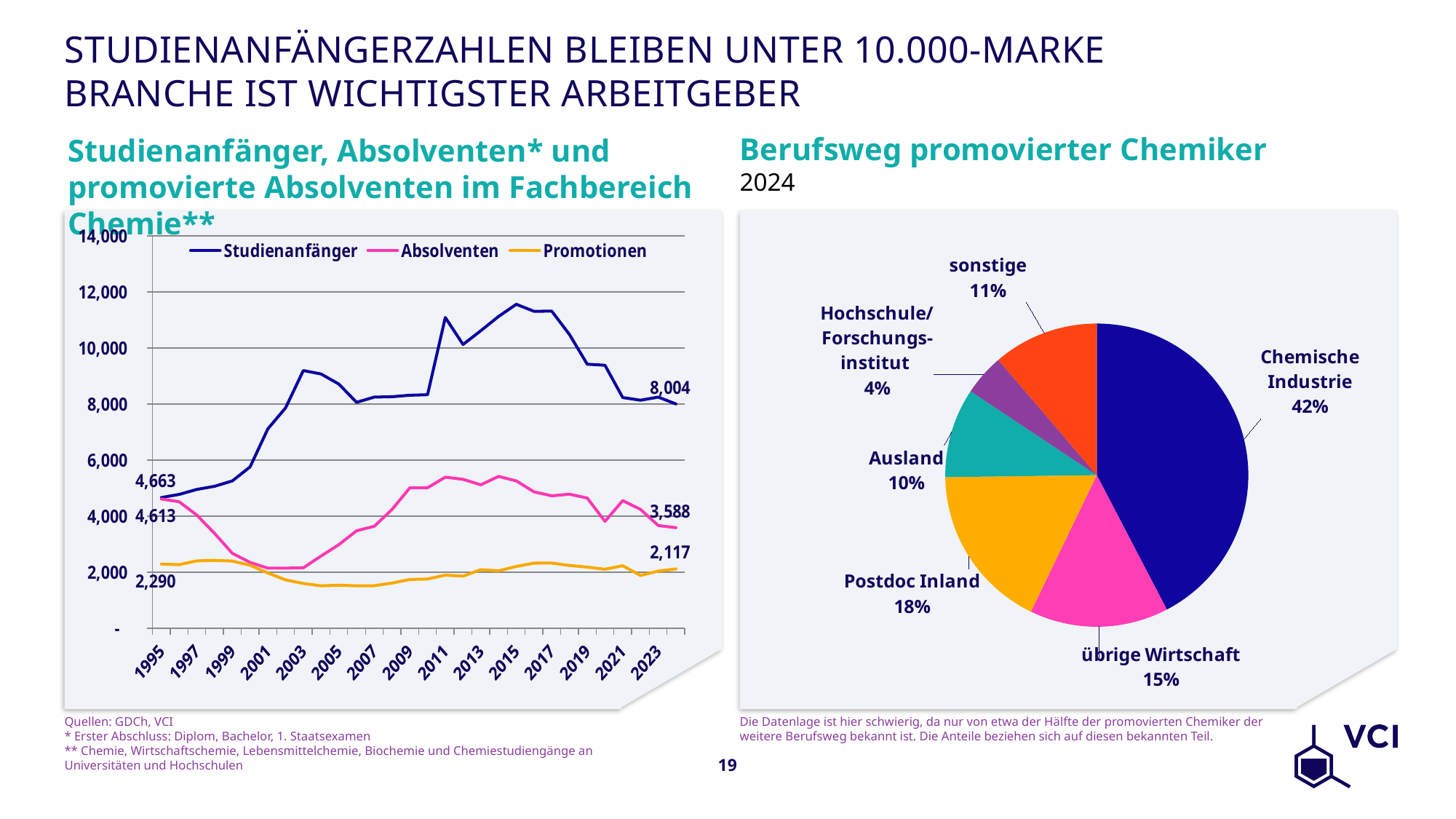
In the left line chart, what is the value labelled at the end of the Studienanfänger series? 8,004 In the left line chart, what is the value labelled at the start (1995) of the Absolventen series? 4,613 In the left line chart, what is the value labelled at the end of the Promotionen series? 2,117 In the left line chart, by how much does the labelled end value of the Studienanfänger series (8,004) exceed its labelled 1995 value (4,663)? 3,341 In the pie chart 'Berufsweg promovierter Chemiker 2024', how many slices are there? 6 In the pie chart 'Berufsweg promovierter Chemiker 2024', which category has the smallest share? Hochschule/Forschungsinstitut In the left line chart, is the Studienanfänger value in 2015 greater or less than 10,000? greater In the pie chart 'Berufsweg promovierter Chemiker 2024', which category has the largest share? Chemische Industrie In the pie chart 'Berufsweg promovierter Chemiker 2024', what share does Postdoc Inland have? 18% What kind of chart is the left chart, 'Studienanfänger, Absolventen* und promovierte Absolventen im Fachbereich Chemie**'? Line chart How many series does the legend of the left line chart list? 3 In the left line chart, does the Studienanfänger series rise or fall between 2017 and 2023? Fall